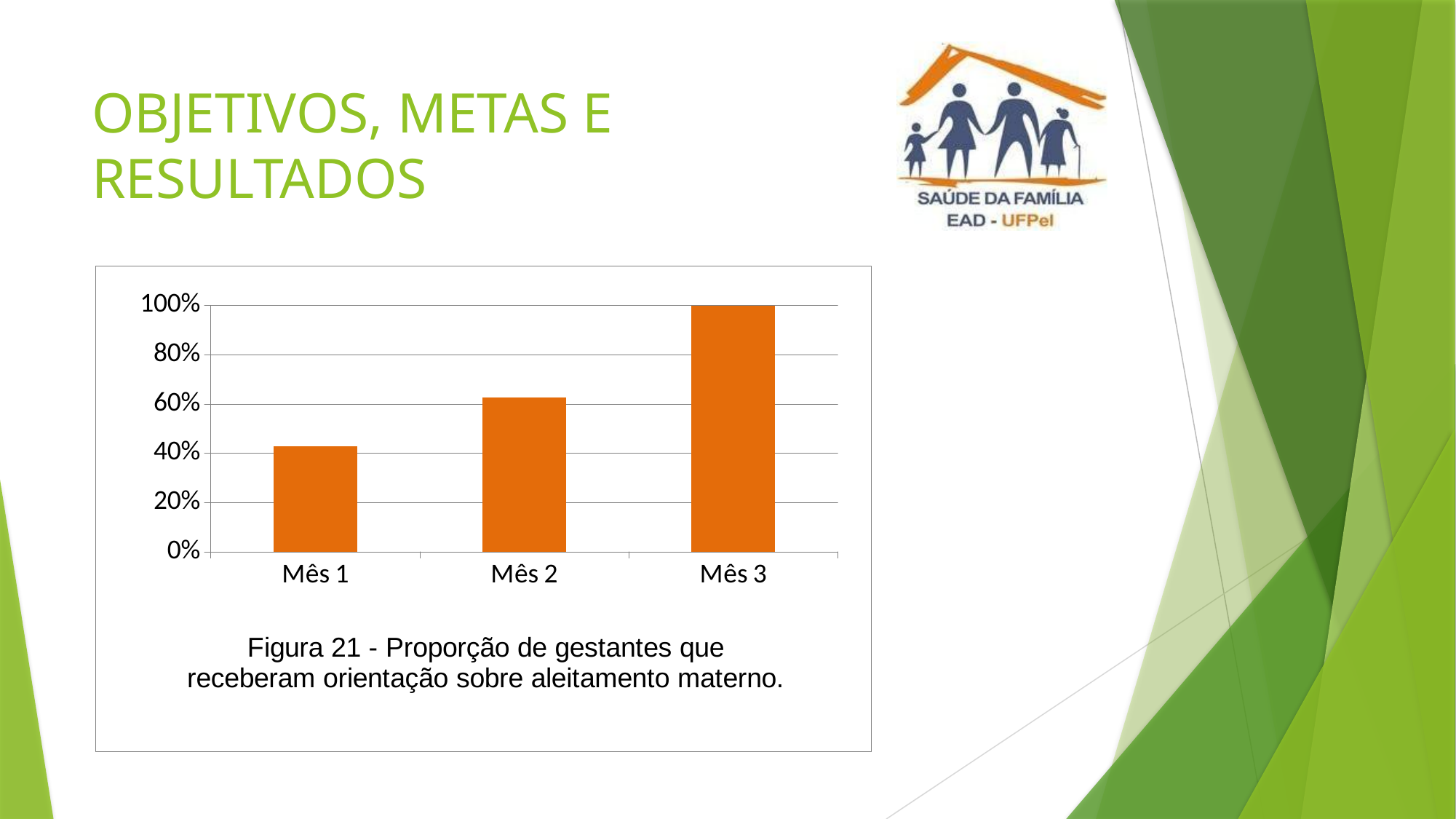
What is the value for Mês 3? 100% What kind of chart is shown on the slide? bar chart Which month has the lowest value in the chart? Mês 1 Is the value for Mês 2 greater or less than 60%? greater Is the value for Mês 1 greater or less than 60%? less Is the value for Mês 1 greater or less than 40%? greater What is the figure number given in the chart caption? Figura 21 How many bars (months) are plotted in the chart? 3 Do the values rise or fall from Mês 1 to Mês 3? rise Which month has the highest value in the chart? Mês 3 Which is larger, the value for Mês 1 or the value for Mês 2? Mês 2